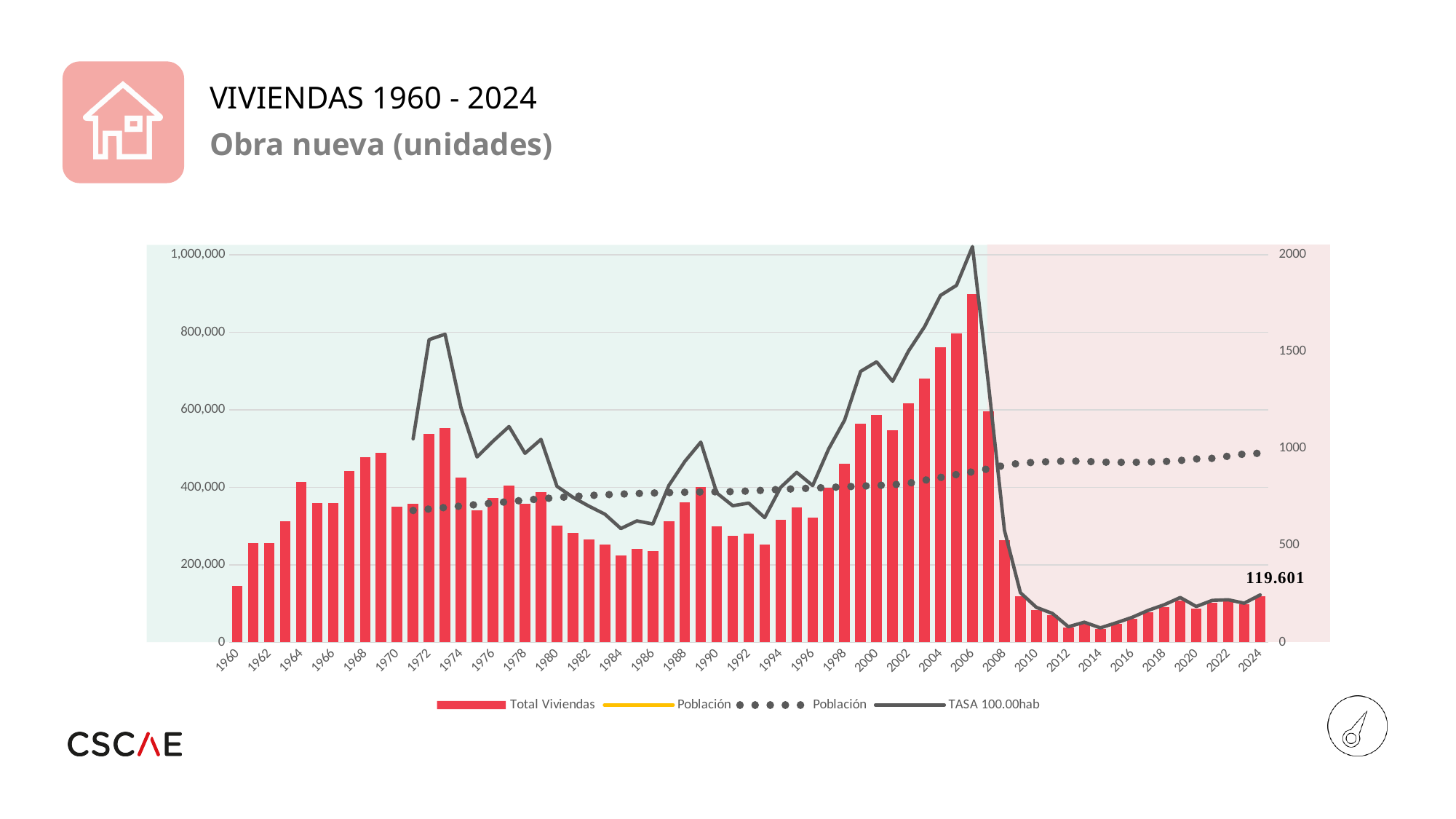
Do the Total Viviendas bars rise or fall from 2006 to 2013? fall What is the subtitle shown under the chart title VIVIENDAS 1960 - 2024? Obra nueva (unidades) How many series does the legend list? 4 In which year is the Total Viviendas bar the highest? 2006 Which year has the larger Total Viviendas bar, 2006 or 1973? 2006 Is the Total Viviendas value for 1973 greater or less than 400,000? greater Do the Total Viviendas bars rise or fall from 1996 to 2006? rise What kind of chart is shown on the slide? bar and line chart Is the Total Viviendas value for 1960 greater or less than 200,000? less What is the labelled value of the Total Viviendas bar for 2024? 119.601 Is the Total Viviendas value for 2006 greater or less than 800,000? greater Which year has the larger Total Viviendas bar, 1988 or 1984? 1988